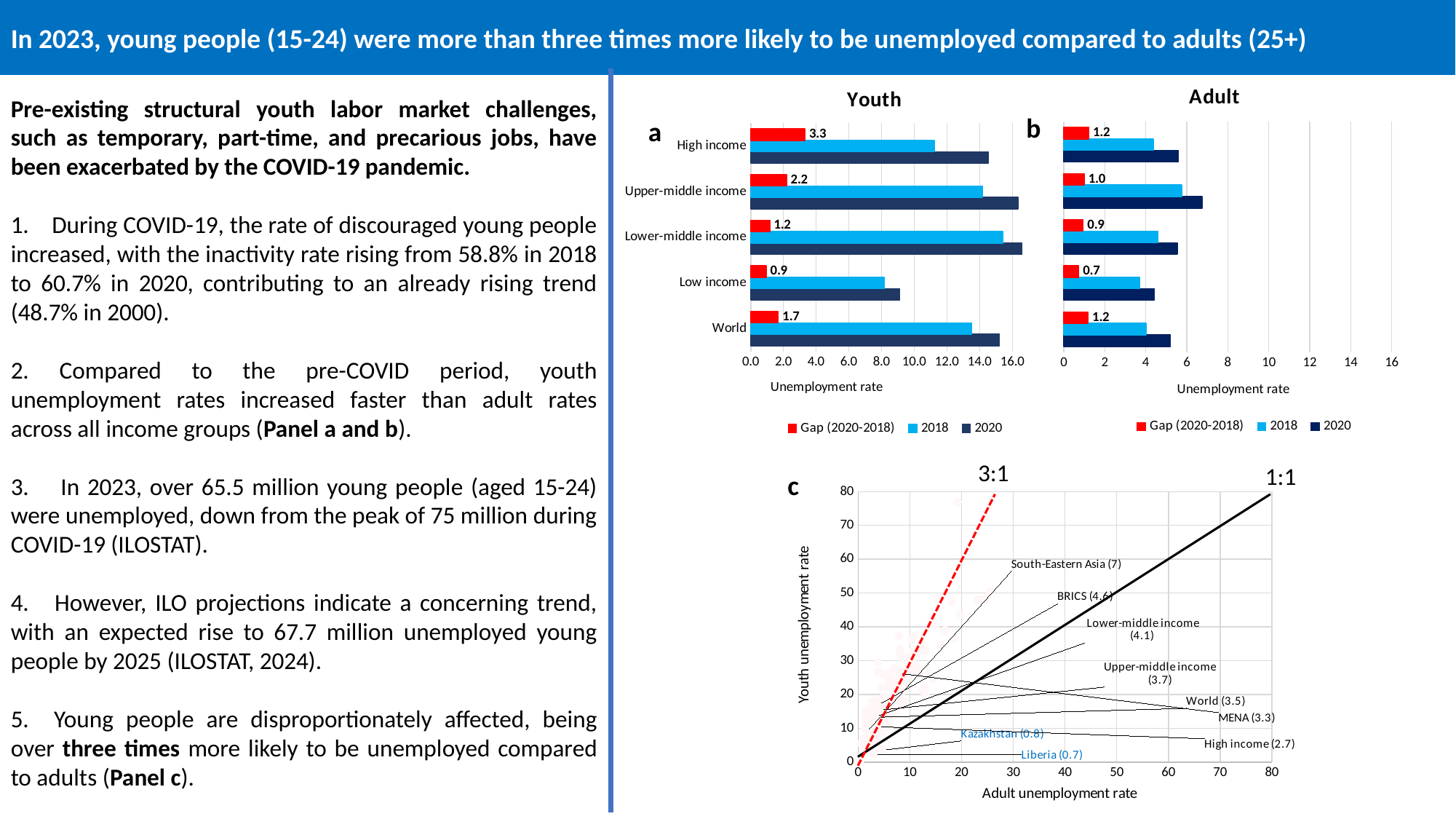
In the Youth chart, which income group has the largest Gap (2020-2018) value? High income In the Youth chart, what is the difference between the Gap (2020-2018) values for High income and Upper-middle income? 1.1 What kind of chart is panel c? Scatter chart How many series does the legend of the Adult chart list? 3 In the Youth chart, what is the Gap (2020-2018) value for High income? 3.3 In panel c, what ratio value is shown in parentheses next to the BRICS label? 4.6 In the Adult chart, what is the Gap (2020-2018) value for Low income? 0.7 How many income categories are shown in the Youth chart? 5 In the Youth chart, is the 2020 unemployment rate for Low income greater or less than 10.0? less In the Adult chart, is the 2020 unemployment rate for Upper-middle income greater or less than 6? greater In the Youth chart, which category has the smallest Gap (2020-2018) value? Low income In the Adult chart, which has a larger Gap (2020-2018) value: Upper-middle income or Lower-middle income? Upper-middle income